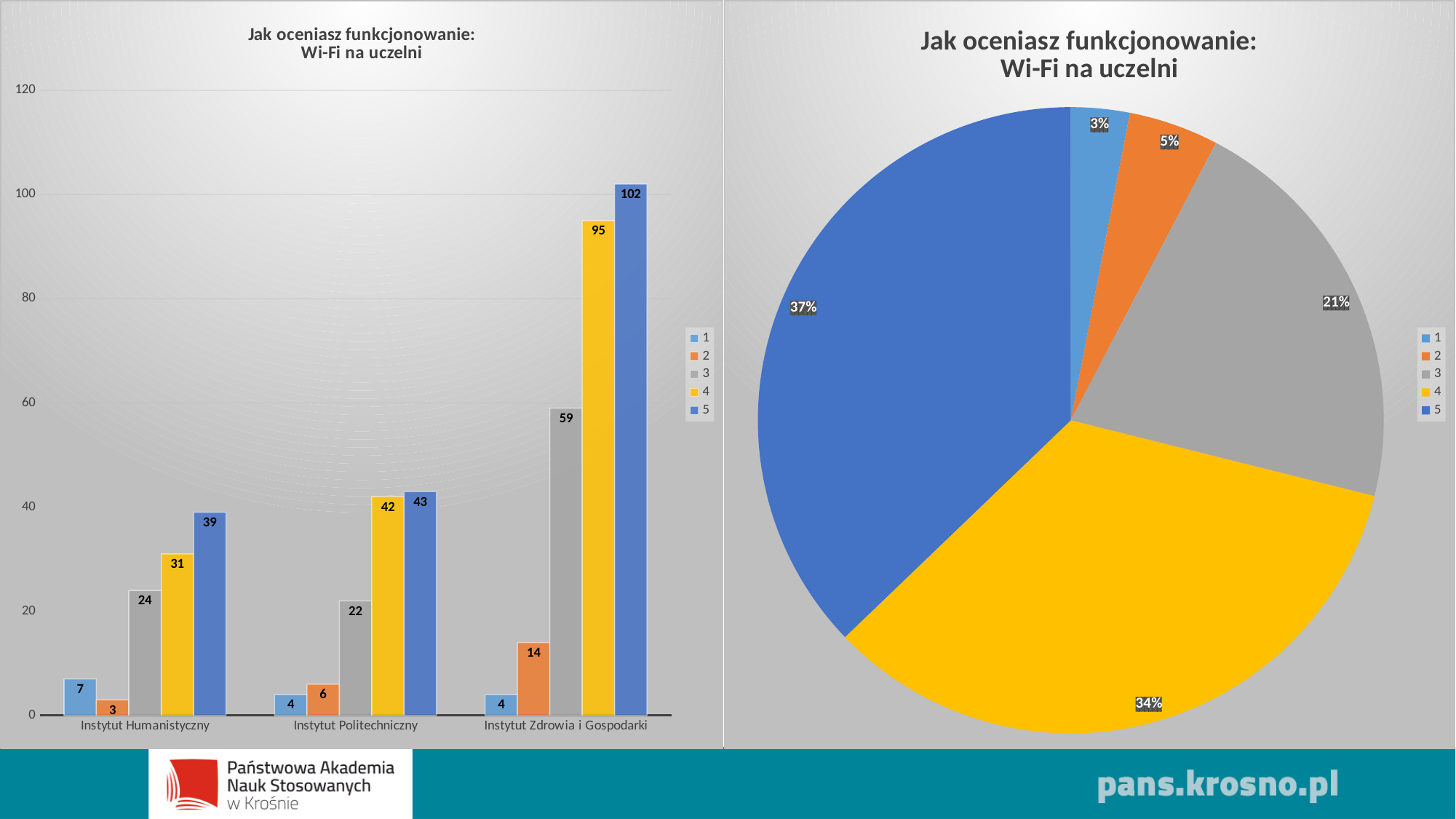
In the bar chart on the left, which series has the lowest value at Instytut Humanistyczny? 2 How many series does the legend of the bar chart on the left list? 5 In the bar chart on the left, what is the value for series 2 at Instytut Politechniczny? 6 How many institutes (categories) are shown on the x axis of the bar chart on the left? 3 What kind of chart is the chart on the right side of the slide? pie chart In the bar chart on the left, what is the value for series 5 at Instytut Zdrowia i Gospodarki? 102 In the pie chart on the right, which slice is the largest? 5 In the bar chart on the left, what is the value for series 3 at Instytut Humanistyczny? 24 In the pie chart on the right, what share does slice 4 have? 34% In the bar chart on the left, what is the difference between series 5 and series 4 at Instytut Zdrowia i Gospodarki? 7 In the bar chart on the left, which series has the highest value at Instytut Zdrowia i Gospodarki? 5 In the bar chart on the left, which is larger at Instytut Politechniczny: series 3 or series 4? 4